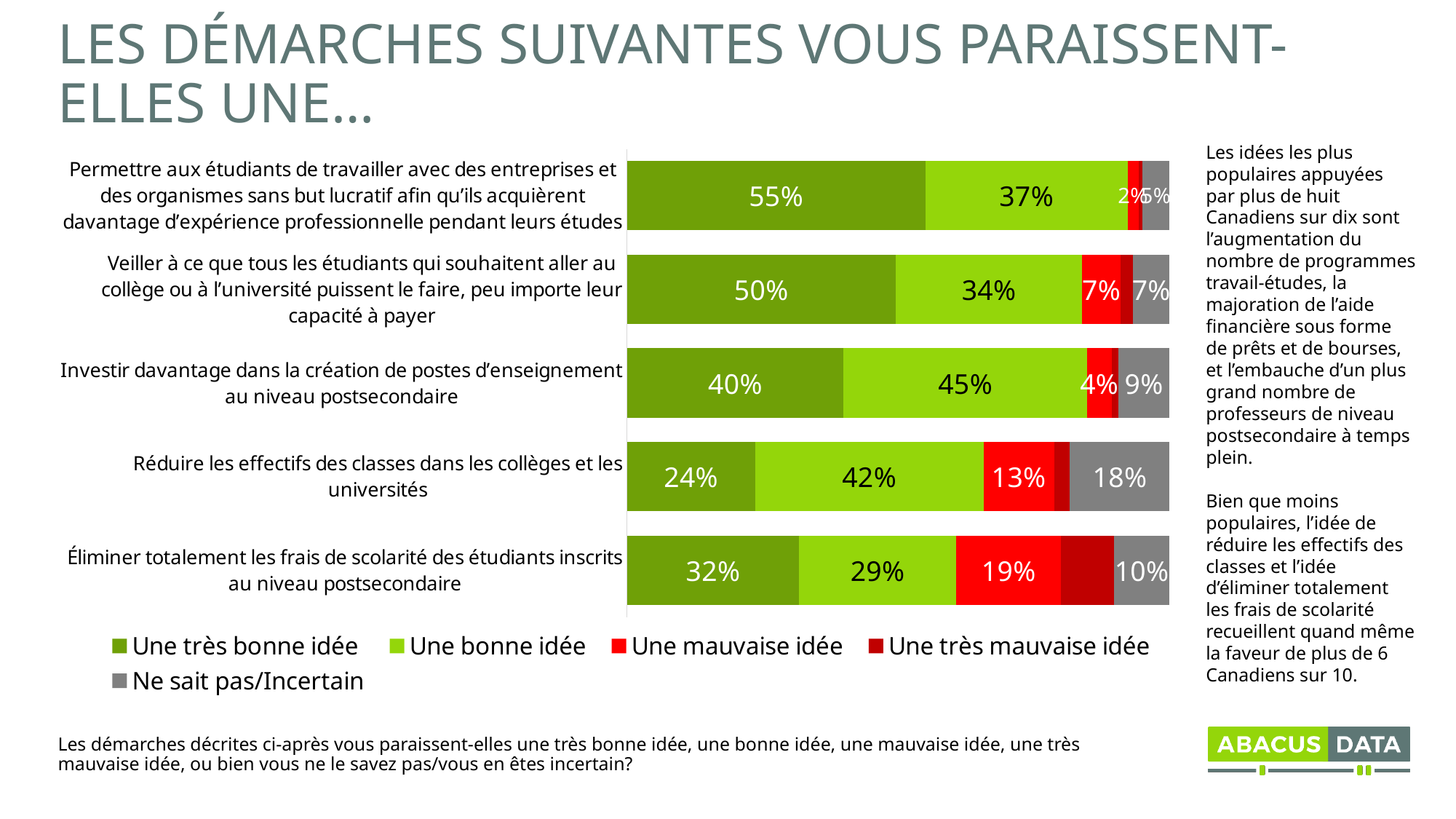
What percentage chose "Une bonne idée" for "Investir davantage dans la création de postes d'enseignement au niveau postsecondaire"? 45% What is the "Ne sait pas/Incertain" value for "Réduire les effectifs des classes dans les collèges et les universités"? 18% For "Investir davantage dans la création de postes d'enseignement au niveau postsecondaire", how many percentage points higher is "Une bonne idée" than "Une très bonne idée"? 5 percentage points How many series does the legend list? 5 Which has the larger "Une bonne idée" share: "Réduire les effectifs des classes" or "Éliminer totalement les frais de scolarité"? Réduire les effectifs des classes dans les collèges et les universités How many proposals (categories) are shown in the chart? 5 Which proposal has the highest "Une très bonne idée" share? Permettre aux étudiants de travailler avec des entreprises et des organismes sans but lucratif afin qu'ils acquièrent davantage d'expérience professionnelle pendant leurs études What percentage chose "Une très bonne idée" for "Veiller à ce que tous les étudiants qui souhaitent aller au collège ou à l'université puissent le faire, peu importe leur capacité à payer"? 50% What percentage chose "Une mauvaise idée" for "Éliminer totalement les frais de scolarité des étudiants inscrits au niveau postsecondaire"? 19% What type of chart is shown on the slide? Stacked bar chart Which proposal has the lowest "Une très bonne idée" share? Réduire les effectifs des classes dans les collèges et les universités What percentage chose "Une très bonne idée" for "Réduire les effectifs des classes dans les collèges et les universités"? 24%